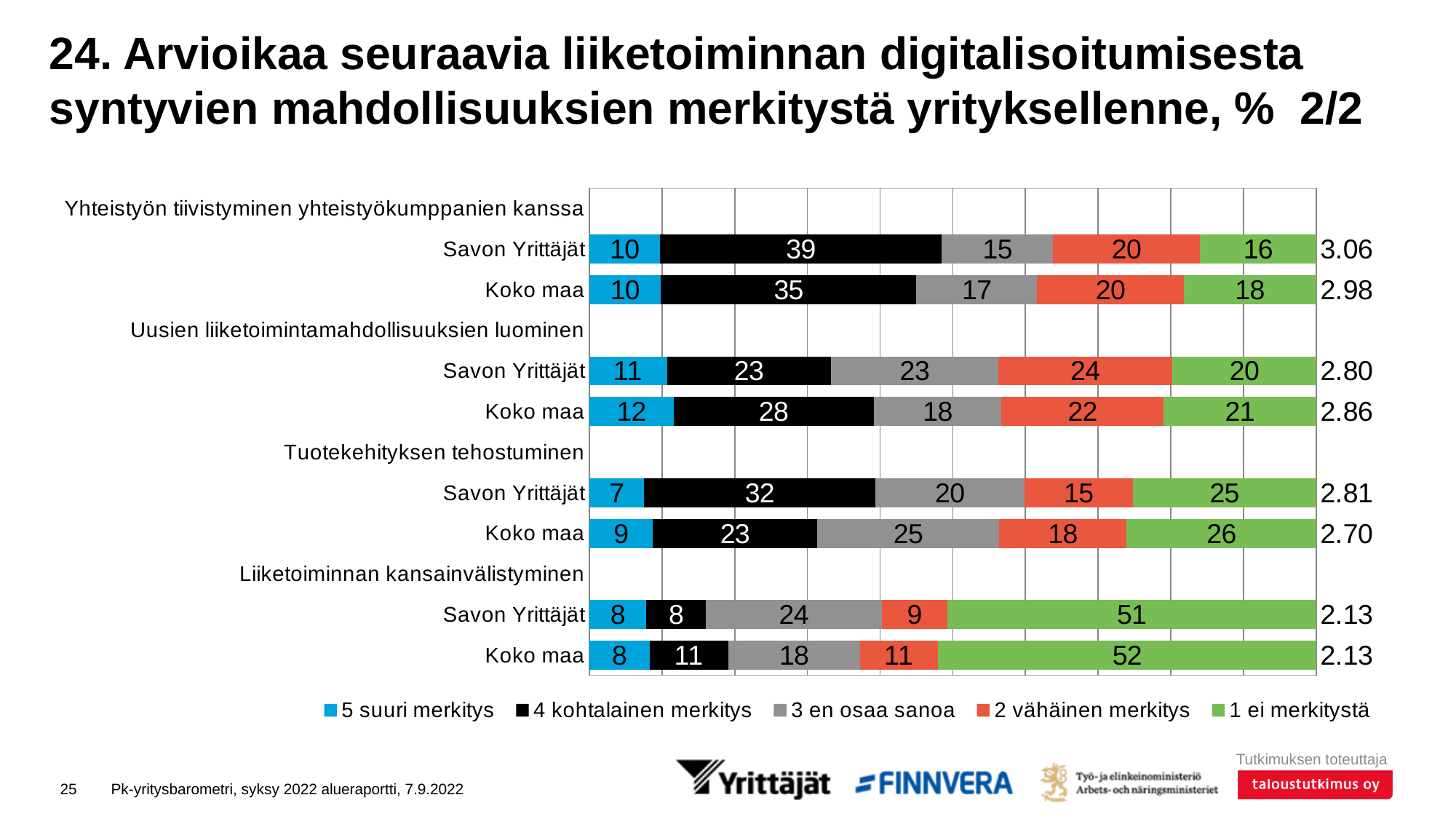
How many series does the legend list? 5 In the Savon Yrittäjät bar of the group "Liiketoiminnan kansainvälistyminen", which series has the largest segment? 1 ei merkitystä In the group "Tuotekehityksen tehostuminen", what is the value of "2 vähäinen merkitys" for Koko maa? 18 What is the total of the Savon Yrittäjät bar in the group "Tuotekehityksen tehostuminen"? 99 In the group "Yhteistyön tiivistyminen yhteistyökumppanien kanssa", what is the difference in "4 kohtalainen merkitys" between Savon Yrittäjät and Koko maa? 4 In the group "Liiketoiminnan kansainvälistyminen", what is the value of "1 ei merkitystä" for Koko maa? 52 What kind of chart is shown on the slide? Stacked bar chart What colour represents "1 ei merkitystä" in the chart? Green In the group "Yhteistyön tiivistyminen yhteistyökumppanien kanssa", what is the value of "5 suuri merkitys" for Savon Yrittäjät? 10 How many topic groups (headings) are shown in the chart? 4 In the group "Uusien liiketoimintamahdollisuuksien luominen", which has the larger value for "3 en osaa sanoa": Savon Yrittäjät or Koko maa? Savon Yrittäjät What is the mean score printed to the right of the Savon Yrittäjät bar in the group "Yhteistyön tiivistyminen yhteistyökumppanien kanssa"? 3.06